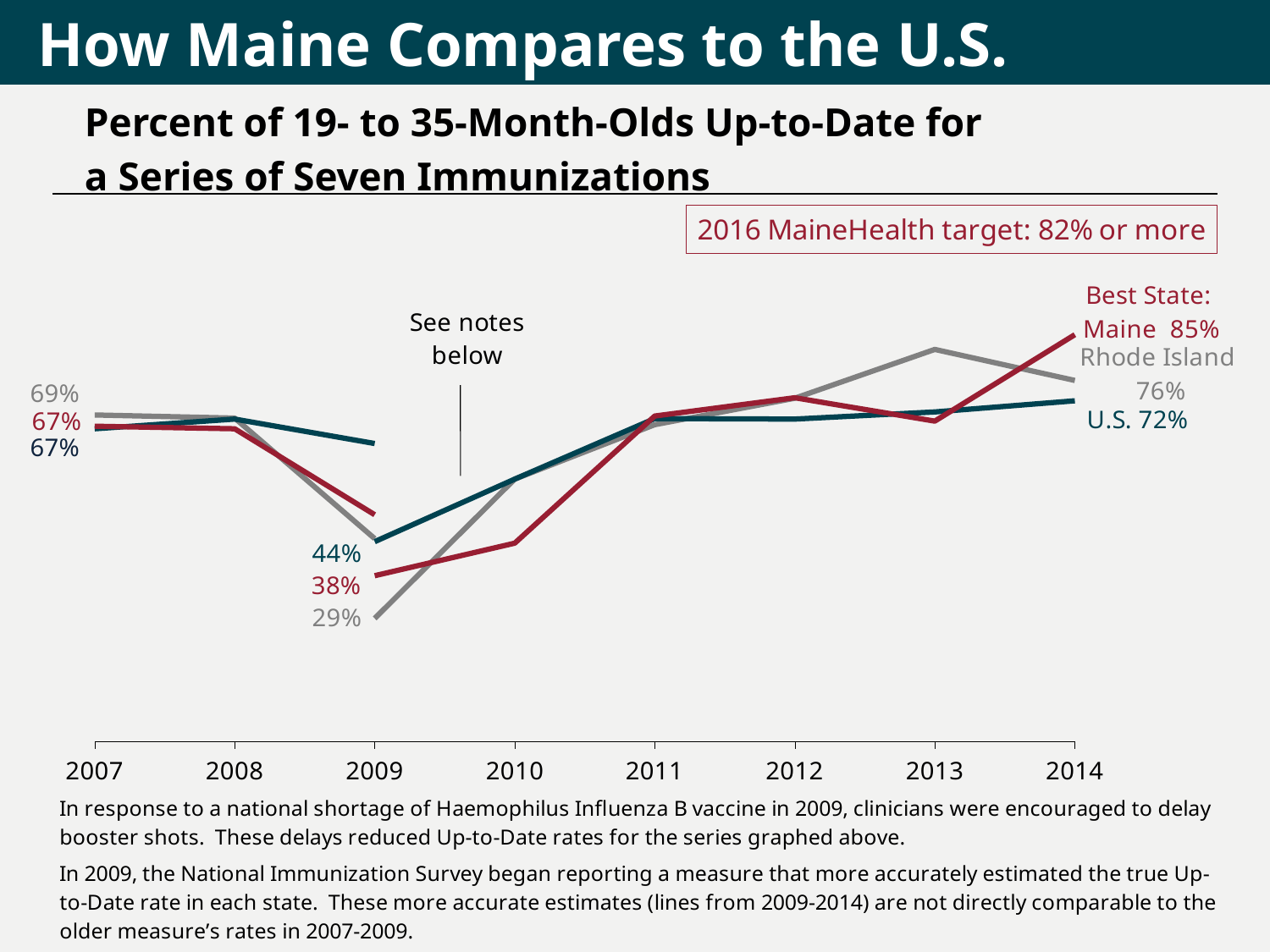
In 2009, which was higher: the U.S. rate or Maine's rate? U.S. What was Maine's Up-to-Date rate in 2014? 85% Which of the three lines had the highest value in 2014? Maine Did Maine's rate rise or fall from 2009 to 2014? Rise Which state is labeled as the Best State in 2014, and what was its rate? Maine, 85% Which of the three lines had the lowest value in 2009? Rhode Island (29%) What was the U.S. Up-to-Date rate in 2014? 72% What was Maine's Up-to-Date rate in 2009 under the new measure? 38% What kind of chart is shown on the slide? Line chart How many percentage points higher was Maine than the U.S. in 2014? 13 percentage points What is the 2016 MaineHealth target shown on the slide? 82% or more How many years are shown on the x axis? 8